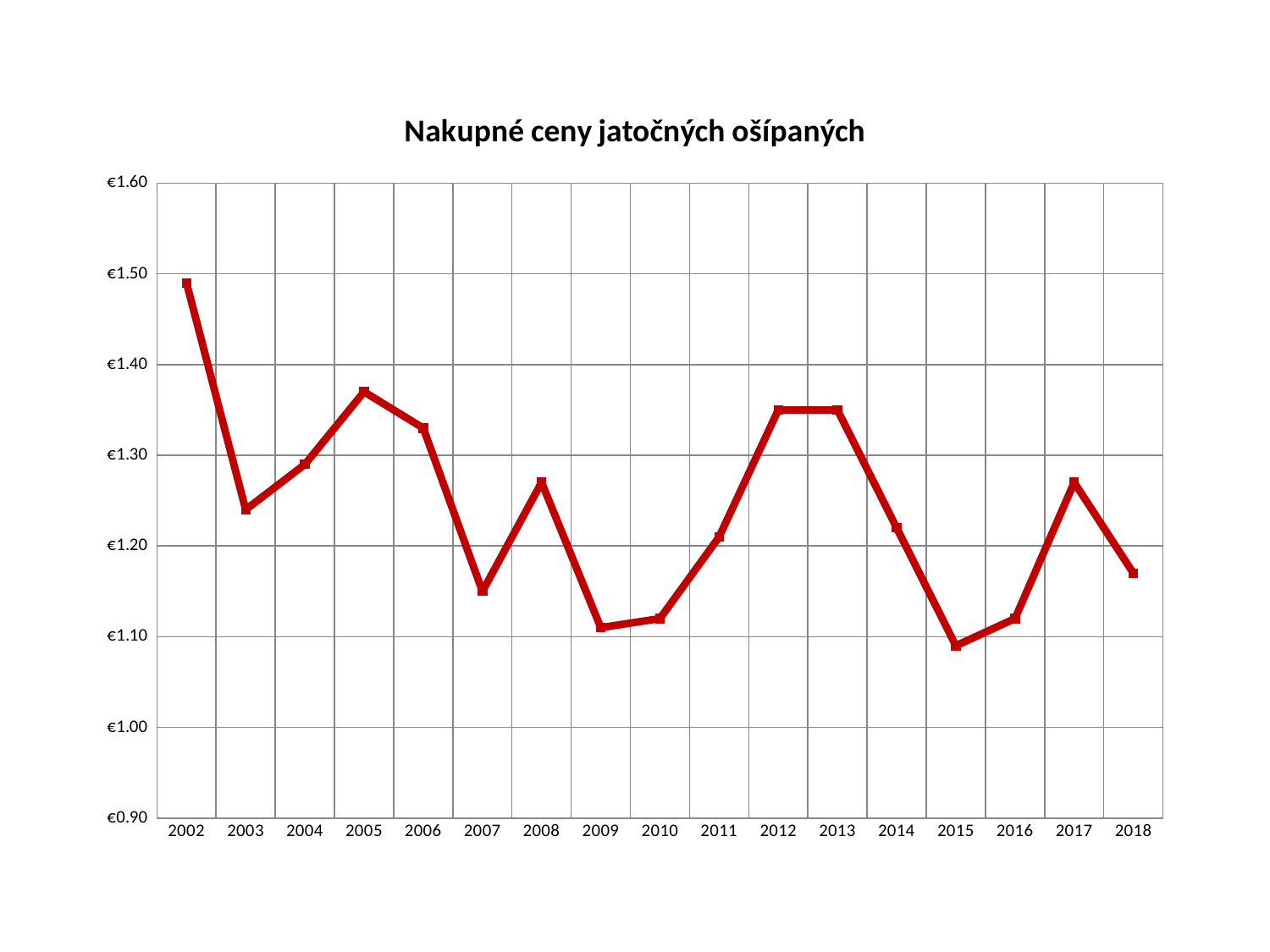
Is the value for 2007 greater or less than €1.20? less Is the value for 2012 greater or less than €1.30? greater Is the value for 2002 greater or less than €1.40? greater What type of chart is shown on the slide? line chart What is the title of the chart? Nakupné ceny jatočných ošípaných Which year has the larger value, 2005 or 2003? 2005 How many years are plotted on the x axis? 17 Do the values rise or fall from 2009 to 2012? rise Which year has the larger value, 2017 or 2018? 2017 Which year has the lowest value? 2015 Which year has the highest value? 2002